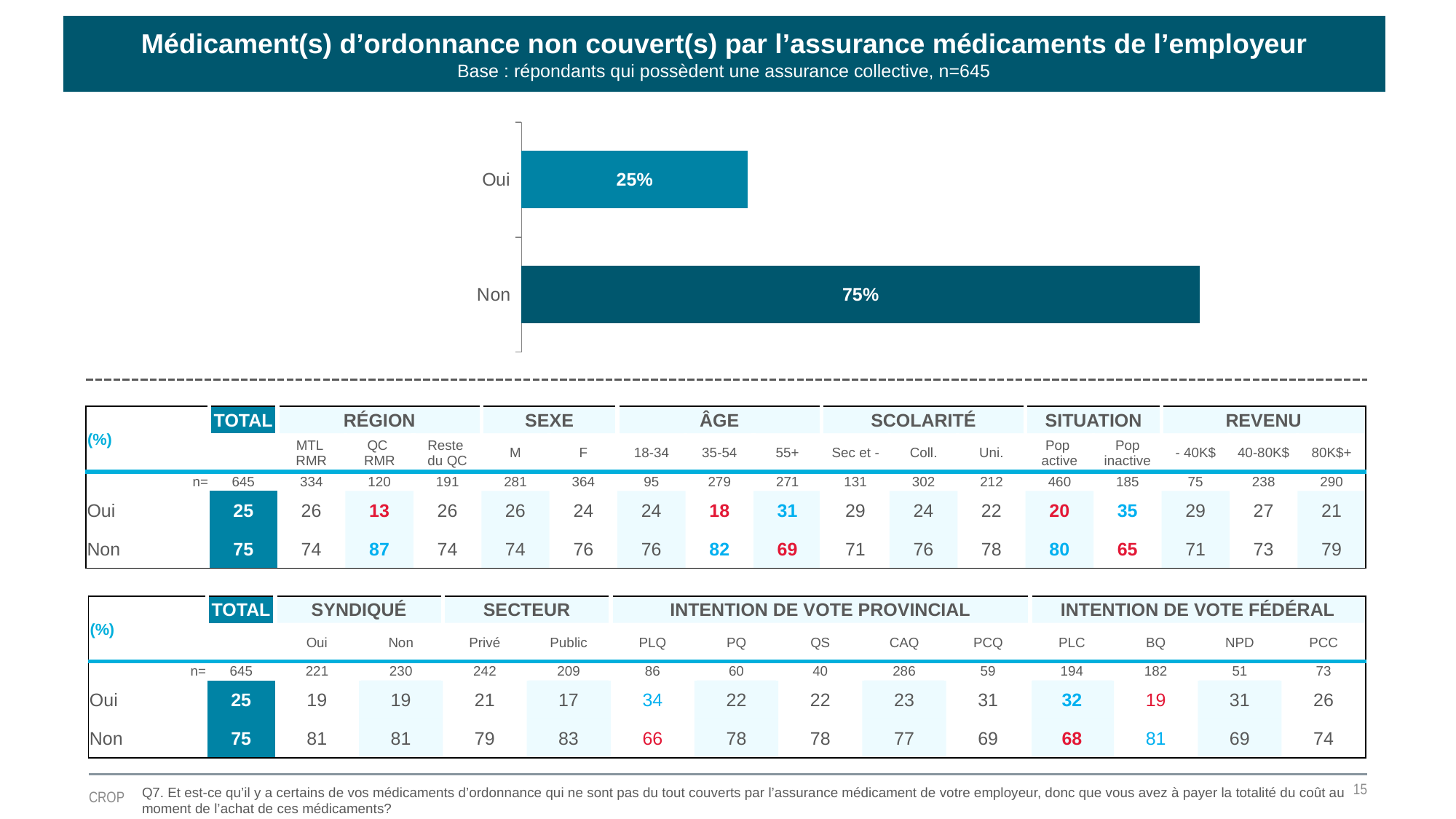
Which is larger in the bar chart, the value for "Oui" or the value for "Non"? Non What is the value for "Oui" in the bar chart? 25% What is the value for "Non" in the bar chart? 75% Which category has the lowest value in the bar chart? Oui What is the base size (n) stated in the chart's subtitle? n=645 Which category has the highest value in the bar chart? Non Which category in the bar chart is drawn in the darker shade of blue? Non What is the difference between the values for "Non" and "Oui" in the bar chart? 50% What kind of chart is shown on the slide? Bar chart How many categories are shown in the bar chart? 2 What is the total of the two values shown in the bar chart? 100%